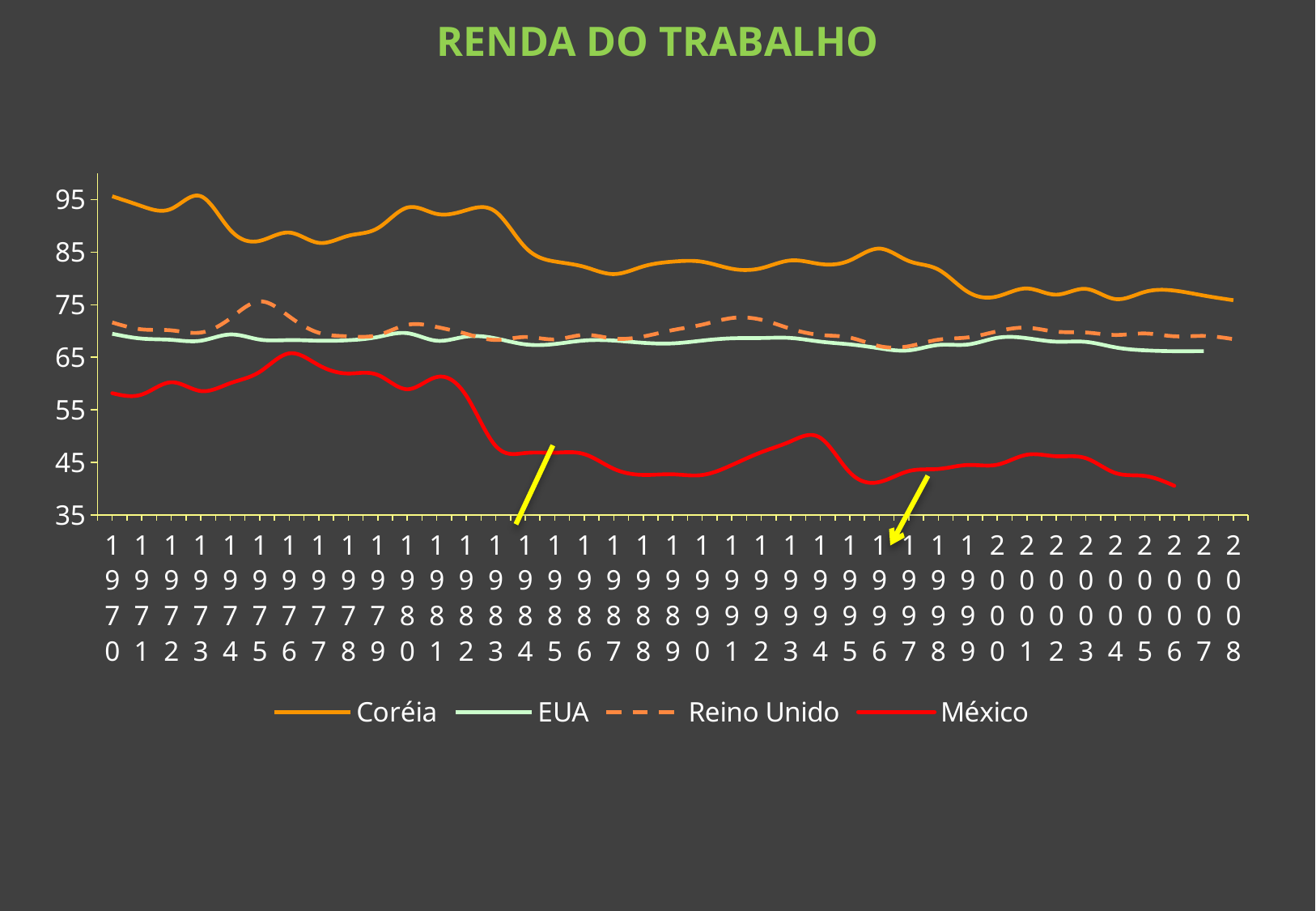
Which series is drawn with a dashed line? Reino Unido How many series does the legend list? 4 Is the value for Coréia in 1970 greater or less than 85? greater In 1975, which is higher: Reino Unido or EUA? Reino Unido Is the value for EUA in 1970 greater or less than 65? greater Which series has the highest values across the chart? Coréia Does the Coréia line rise or fall from 1970 to 2008? fall How many years are shown along the x axis? 39 Which series has the lowest values across the chart? México What kind of chart is shown on the slide? line chart Does the México line rise or fall from 1970 to 2008? fall